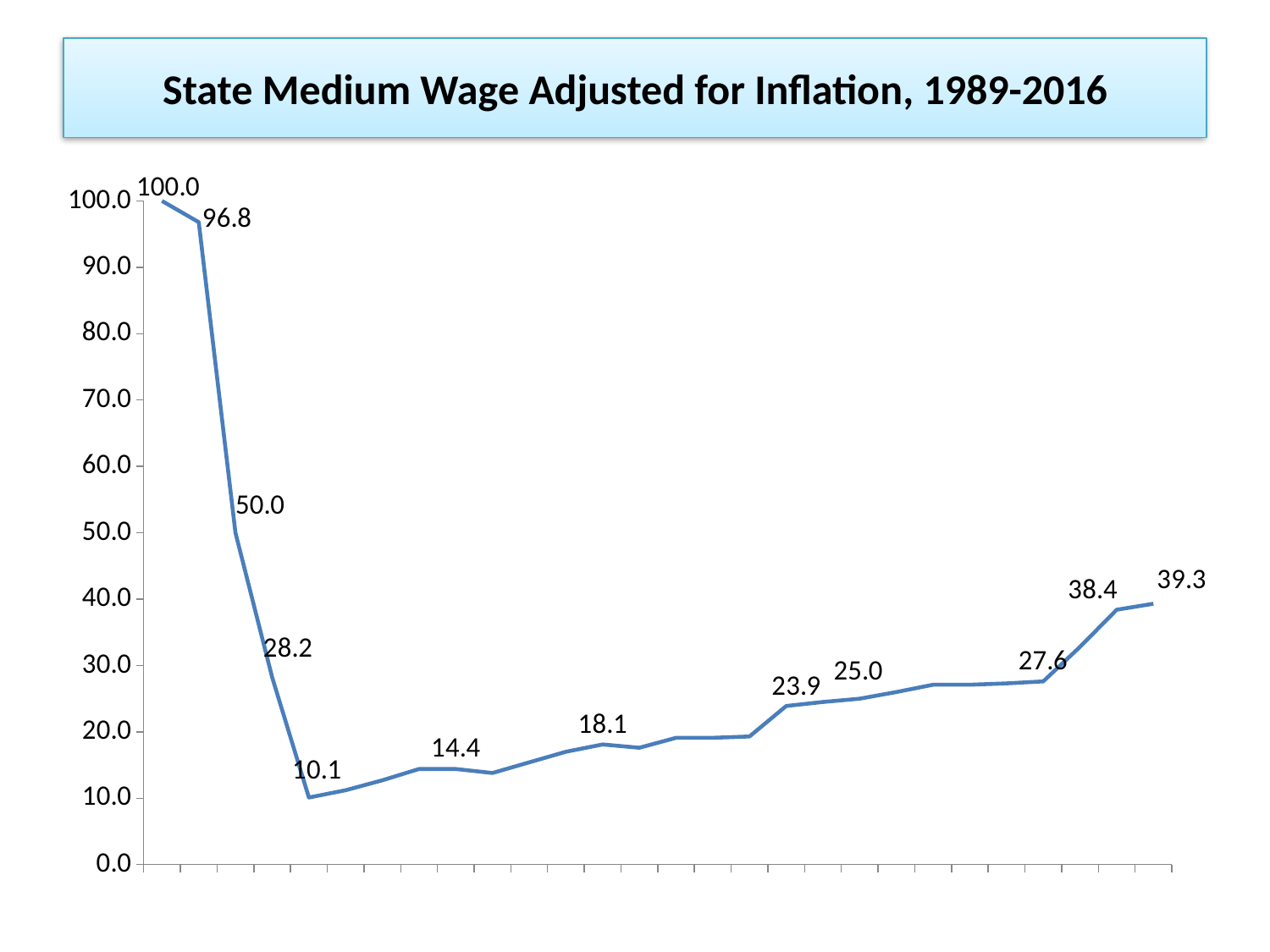
Does the line generally rise or fall from the point labeled 10.1 to the last point? rise What is the difference between the highest labeled value (100.0) and the lowest labeled value (10.1)? 89.9 Does the line rise or fall from the first point to the point labeled 10.1? fall What is the value of the last point on the line? 39.3 What is the lowest labeled value on the line? 10.1 What is the value of the first point on the line? 100.0 What is the highest labeled value on the line? 100.0 Which is larger, the second labeled value (96.8) or the third labeled value (50.0)? 96.8 How many lines (series) are plotted on the chart? 1 What is the title of the chart? State Medium Wage Adjusted for Inflation, 1989-2016 What is the difference between the last two labeled values, 39.3 and 38.4? 0.9 What kind of chart is shown on the slide? line chart